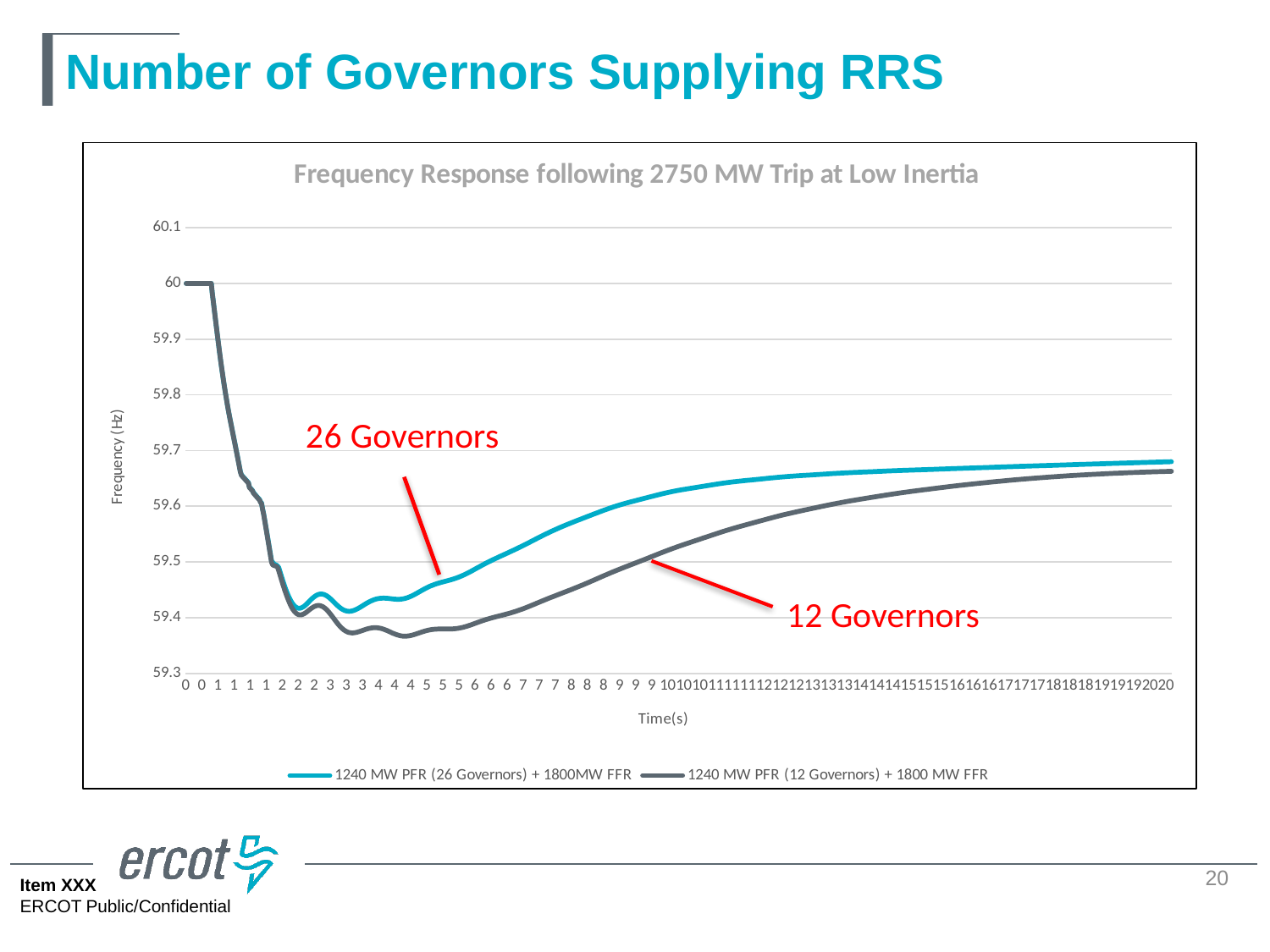
At time 8 s, which curve has the higher frequency, 26 Governors or 12 Governors? 26 Governors What is the frequency value of both curves at time 0, before the trip? 60 Is the minimum frequency of the 12 Governors curve greater or less than 59.4? less What is the label of the vertical axis? Frequency (Hz) How many series does the legend list? 2 Is the value of the 26 Governors curve at time 20 s greater or less than 59.6? greater Is the value of the 12 Governors curve at time 5 s greater or less than 59.5? less What is the highest value shown on the frequency axis? 60.1 Which curve reaches the lower minimum frequency, 26 Governors or 12 Governors? 12 Governors What is the title of the chart? Frequency Response following 2750 MW Trip at Low Inertia What kind of chart is shown on the slide? Line chart After reaching their minimum, do the frequency curves rise or fall as time increases toward 20 s? rise